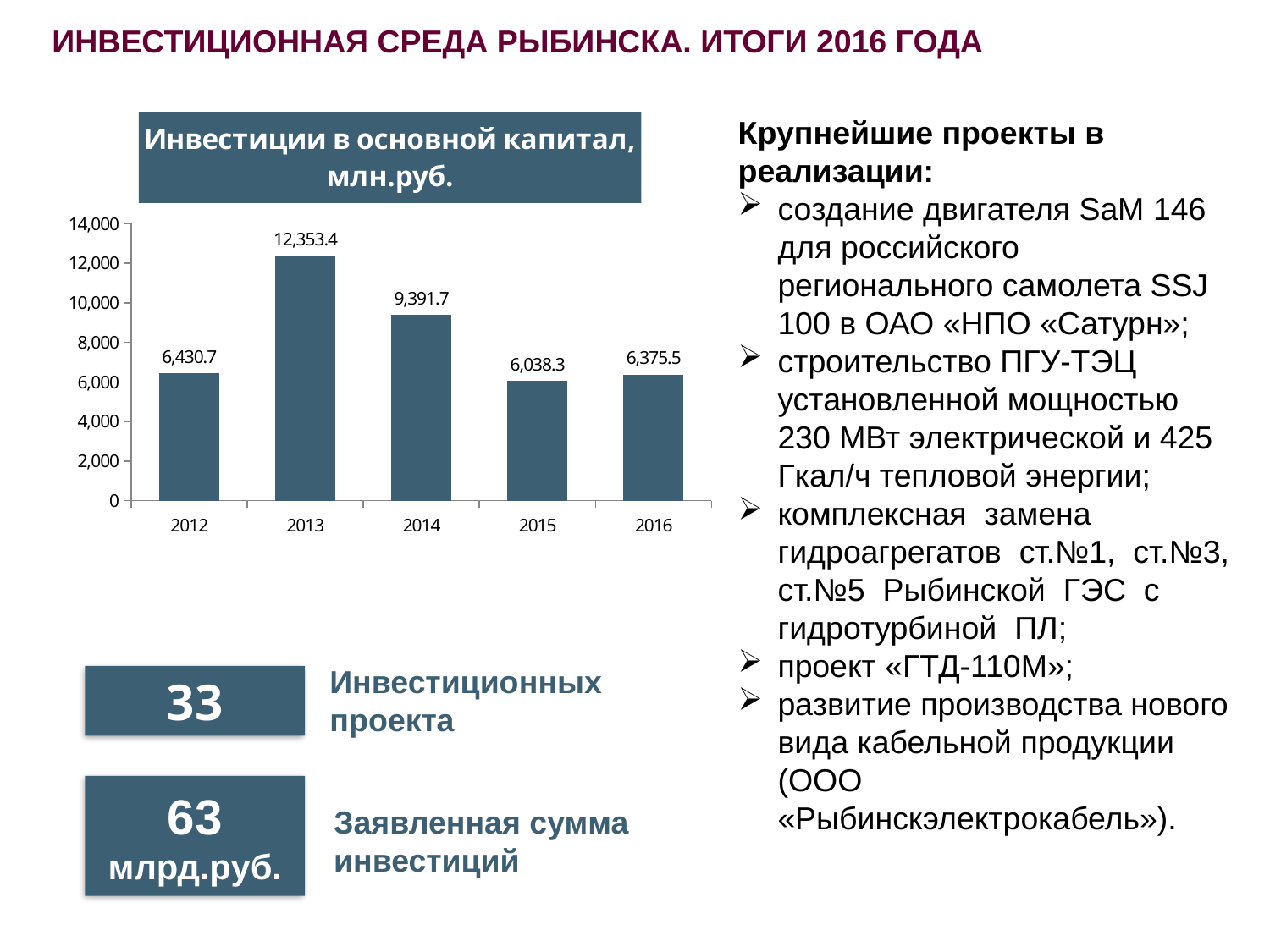
Which year has the lowest value in the chart 'Инвестиции в основной капитал, млн.руб.'? 2015 What is the difference between the 2013 and 2014 values in the chart 'Инвестиции в основной капитал, млн.руб.'? 2,961.7 Which year has the highest value in the chart 'Инвестиции в основной капитал, млн.руб.'? 2013 How many years are shown in the chart 'Инвестиции в основной капитал, млн.руб.'? 5 What is the value for 2013 in the chart 'Инвестиции в основной капитал, млн.руб.'? 12,353.4 Is the value for 2014 in the chart 'Инвестиции в основной капитал, млн.руб.' greater or less than 8,000? greater What is the value for 2015 in the chart 'Инвестиции в основной капитал, млн.руб.'? 6,038.3 In the chart 'Инвестиции в основной капитал, млн.руб.', which is larger: the value for 2014 or the value for 2016? 2014 What is the value for 2016 in the chart 'Инвестиции в основной капитал, млн.руб.'? 6,375.5 What is the difference between the 2012 and 2016 values in the chart 'Инвестиции в основной капитал, млн.руб.'? 55.2 In the chart 'Инвестиции в основной капитал, млн.руб.', do the values rise or fall from 2013 to 2015? fall What kind of chart is 'Инвестиции в основной капитал, млн.руб.'? bar chart